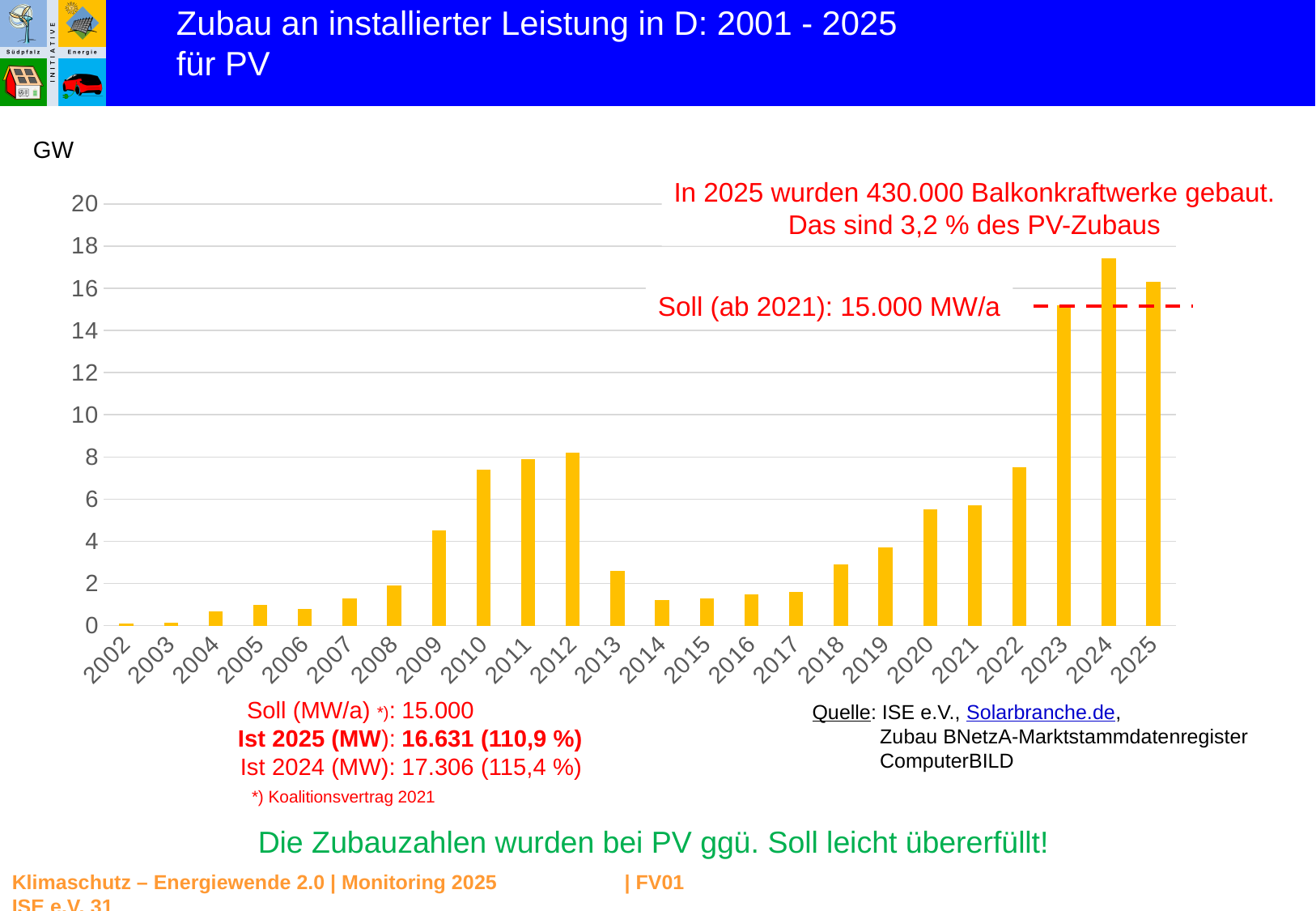
According to the text below the chart, what was the Ist 2025 value in MW? 16.631 Is the value for 2023 greater or less than 14 GW? greater What is the Soll (target) value per year shown by the dashed line? 15.000 MW/a Do the values rise or fall from 2009 to 2012? rise Is the value for 2022 greater or less than 6 GW? greater Is the value for 2013 greater or less than 4 GW? less How many years are shown on the x axis of the chart? 24 What is the difference in MW between the Ist 2024 and Ist 2025 values given on the slide? 675 Which year has the highest PV-Zubau in the chart? 2024 According to the text below the chart, what was the Ist 2024 value in MW? 17.306 Which year has the larger value, 2012 or 2013? 2012 What kind of chart is shown on the slide? bar chart